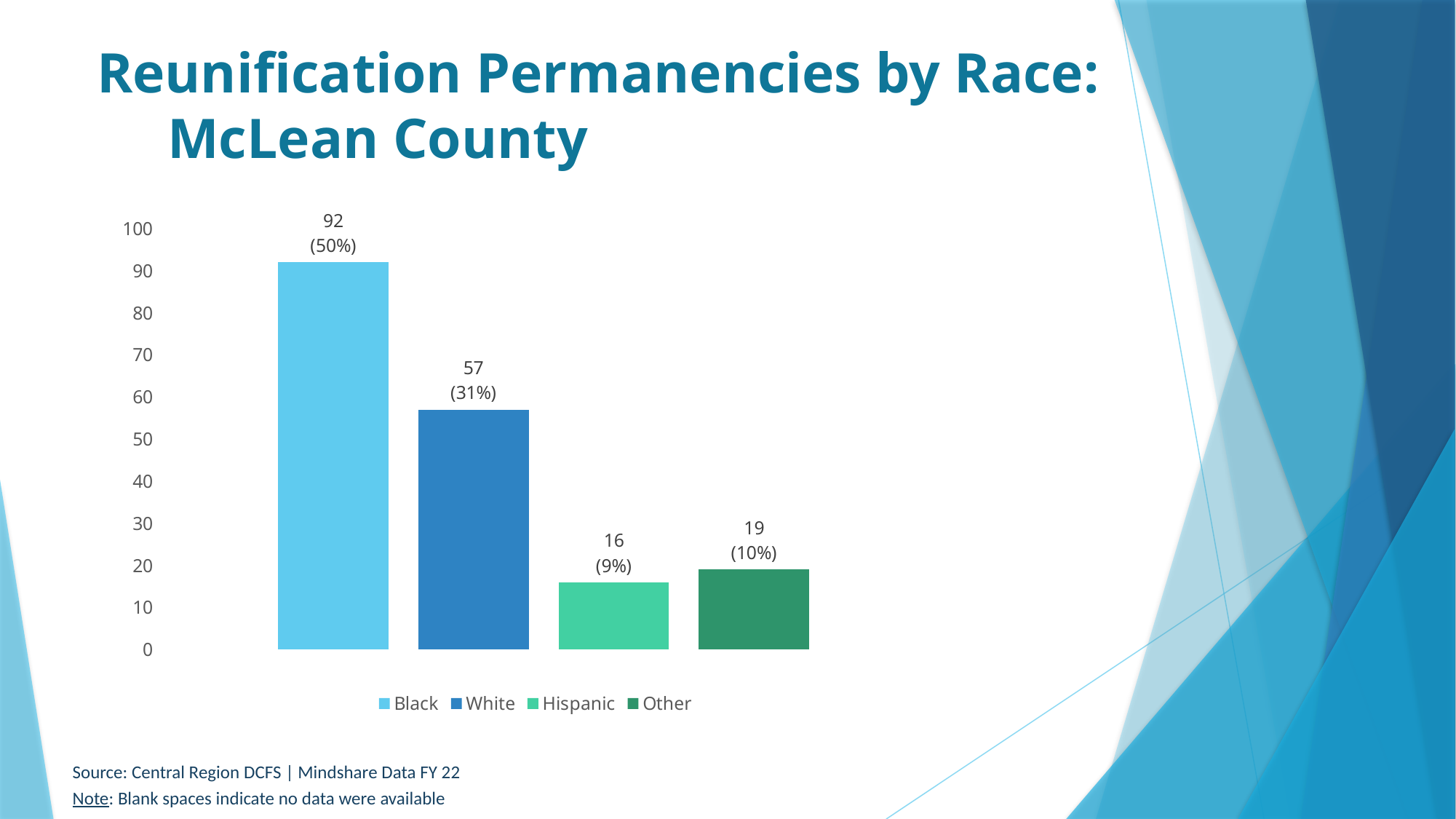
Is the value for White greater or less than 50? greater Which is larger, the value for Other or the value for Hispanic? Other What is the title of the slide? Reunification Permanencies by Race: McLean County What is the value for Black? 92 Which category has the lowest value? Hispanic What percentage is shown for Other? 10% What kind of chart is shown on the slide? bar chart What is the difference between the values for Black and White? 35 How many categories are shown in the chart? 4 What is the value for White? 57 What is the value for Hispanic? 16 Which category has the highest value? Black